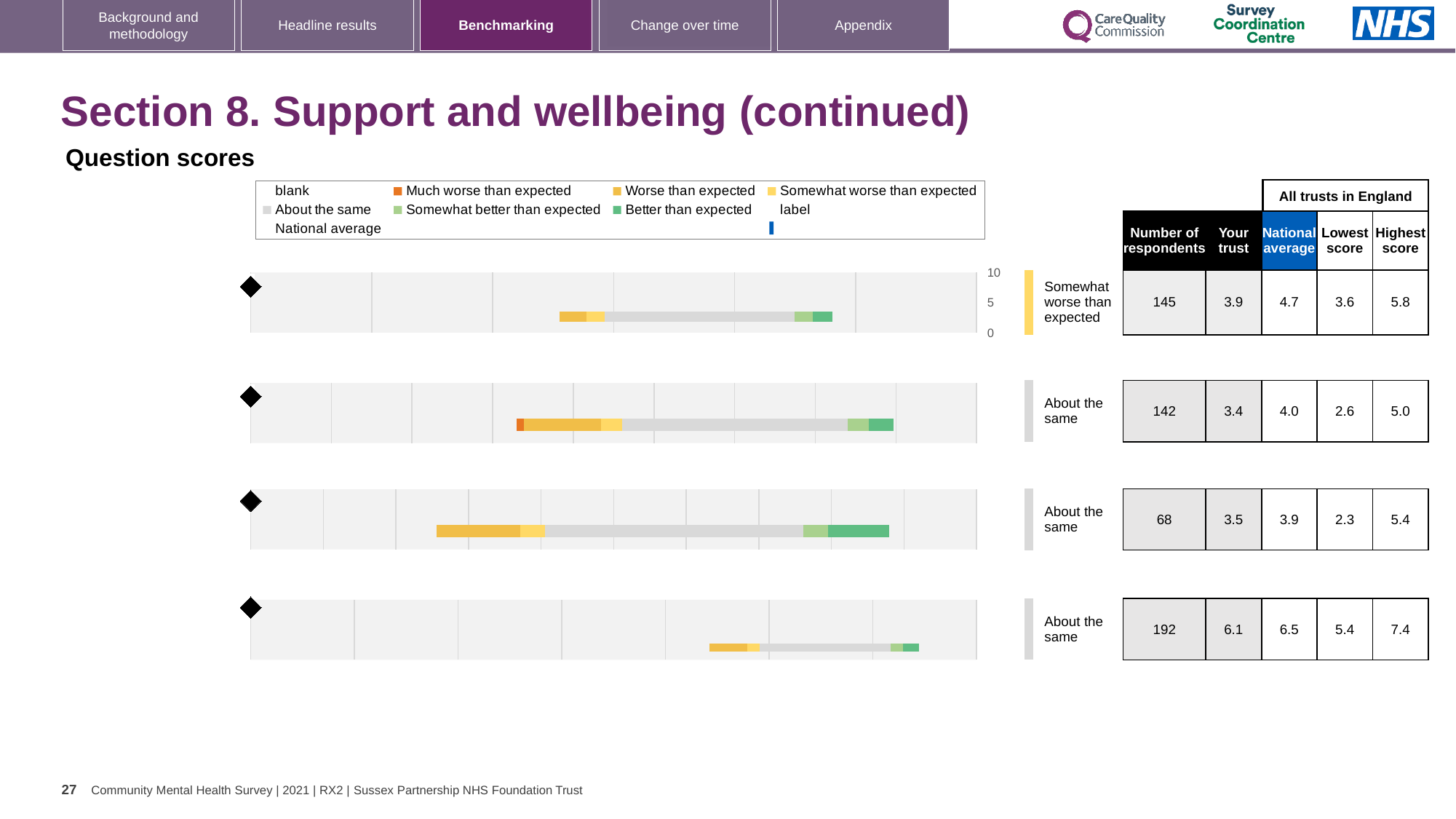
For the fourth chart from the top, what is the highest score among all trusts in England? 7.4 For the fourth chart from the top, what is the difference between the national average and the 'Your trust' score? 0.4 Which chart has the lowest number of respondents? the third chart from the top Which chart has the highest 'Your trust' score? the fourth chart from the top Which benchmark category label is shown next to the first chart from the top? Somewhat worse than expected How many charts are shown on the slide? 4 For the first chart from the top, what is the 'Your trust' score? 3.9 For the first chart from the top, what is the national average score? 4.7 For the second chart from the top, how many respondents are there? 142 What kind of chart is the first chart from the top? bar chart For the third chart from the top, is the 'Your trust' score higher or lower than the national average? lower For the third chart from the top, what is the lowest score among all trusts in England? 2.3